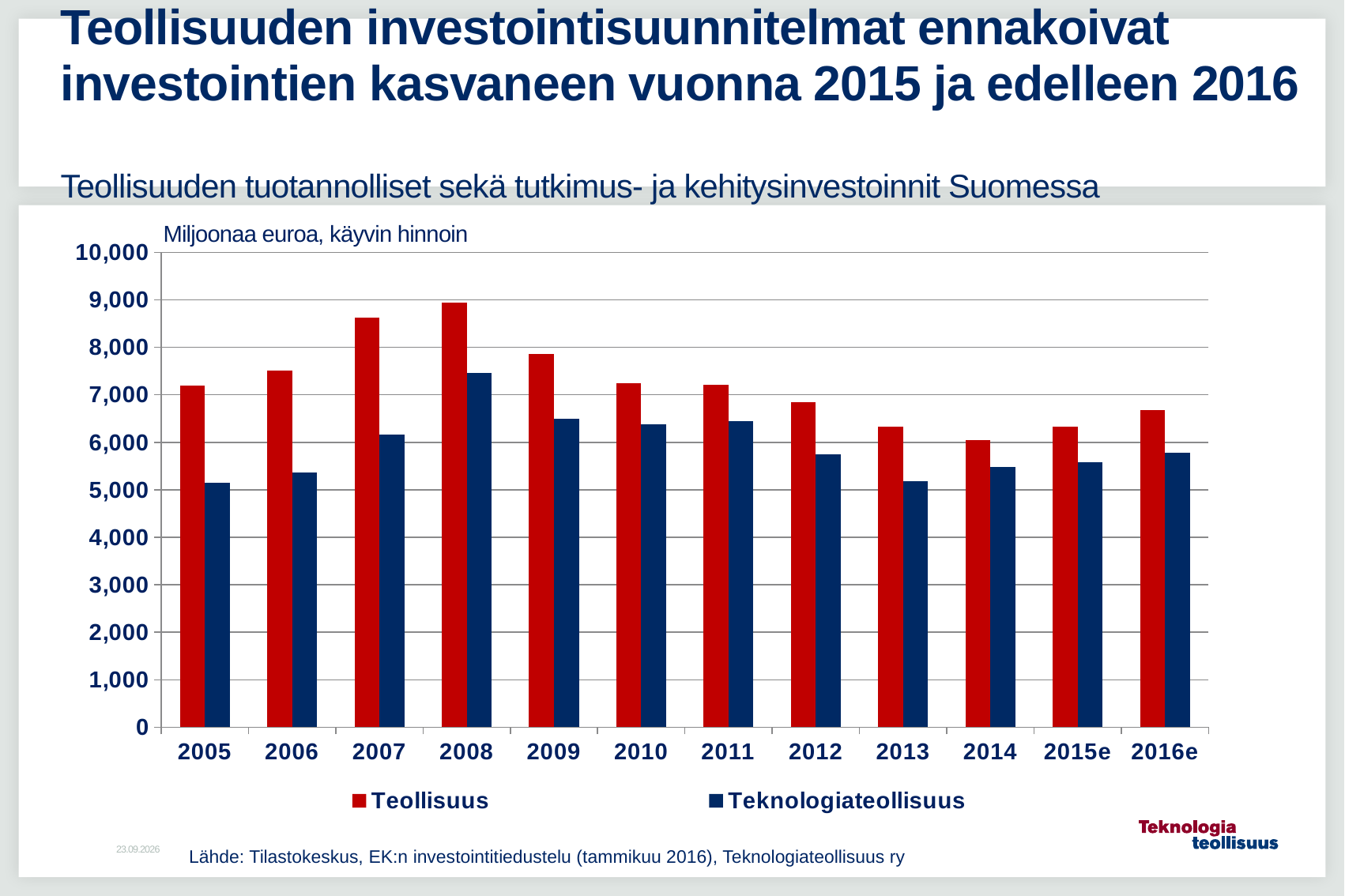
Is the Teknologiateollisuus value for 2012 greater or less than 6,000? less What unit is stated above the y axis of the chart? Miljoonaa euroa, käyvin hinnoin How many years (categories) are shown on the x axis? 12 Does the Teollisuus series rise or fall from 2008 to 2014? fall In which year is the Teknologiateollisuus value highest? 2008 Is the Teknologiateollisuus value for 2008 greater or less than 7,000? greater Which is larger, the Teollisuus value for 2007 or for 2009? 2007 What kind of chart is shown on the slide? bar chart Is the Teollisuus value for 2008 greater or less than 8,000? greater How many series does the legend list? 2 In which year is the Teollisuus value highest? 2008 In which year is the Teollisuus value lowest? 2014